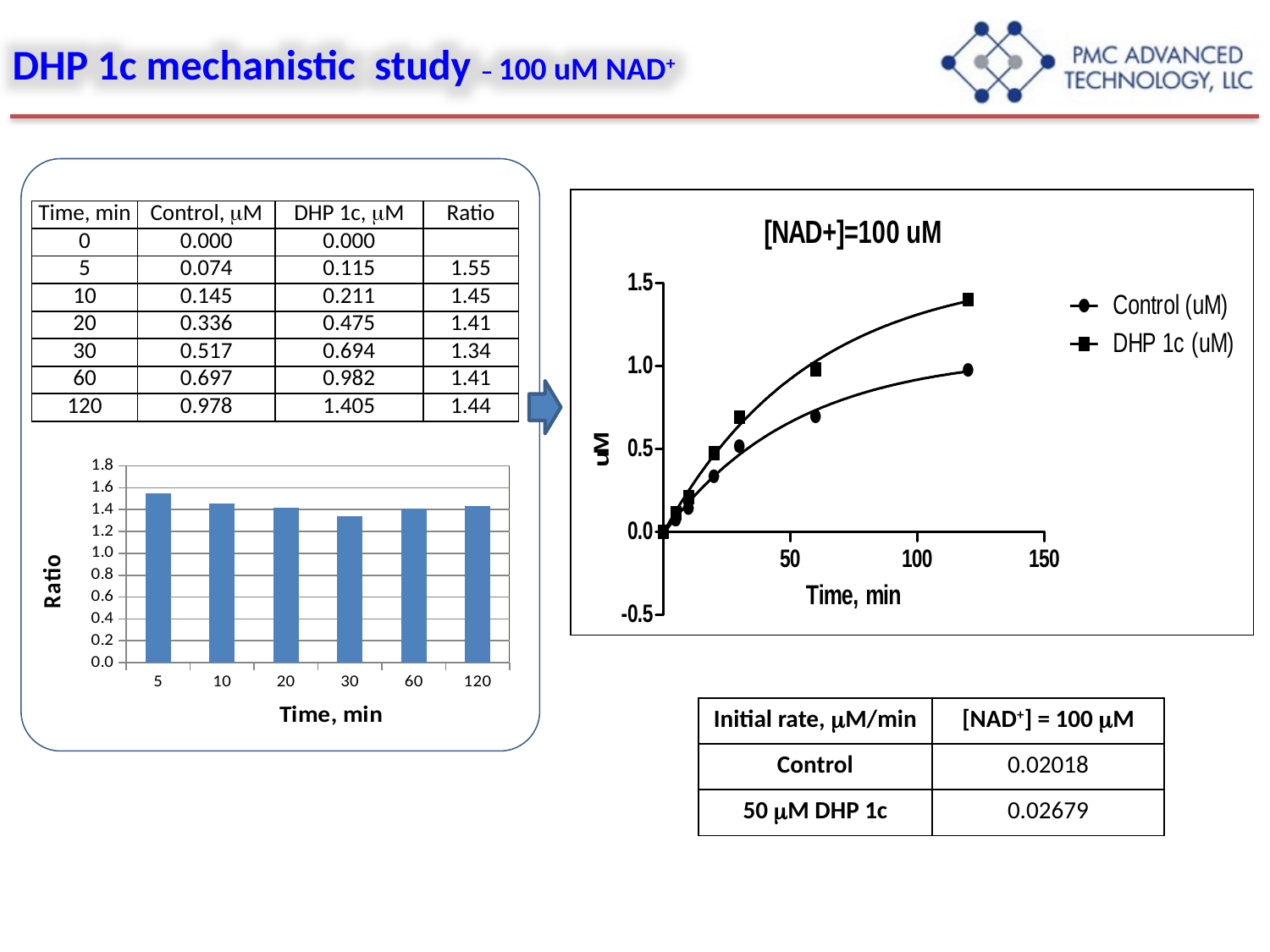
In the bar chart of Ratio versus Time, which time has the lowest ratio? 30 What kind of chart is the chart at the bottom left of the slide with the Ratio axis? bar chart In the bar chart of Ratio versus Time, which time has the highest ratio? 5 In the [NAD+]=100 uM chart, is the DHP 1c (uM) value at 120 min greater or less than 1.0? greater In the [NAD+]=100 uM chart, do the Control (uM) values rise or fall as time increases? rise In the bar chart of Ratio versus Time, how many time categories are shown on the x axis? 6 How many series does the legend of the [NAD+]=100 uM chart list? 2 In the bar chart of Ratio versus Time, is the ratio at 30 min greater or less than 1.4? less In the [NAD+]=100 uM chart, is the Control (uM) value at 60 min greater or less than 0.5? greater What is the title of the chart on the right side of the slide? [NAD+]=100 uM In the bar chart of Ratio versus Time, which is larger, the ratio at 5 min or the ratio at 30 min? 5 min